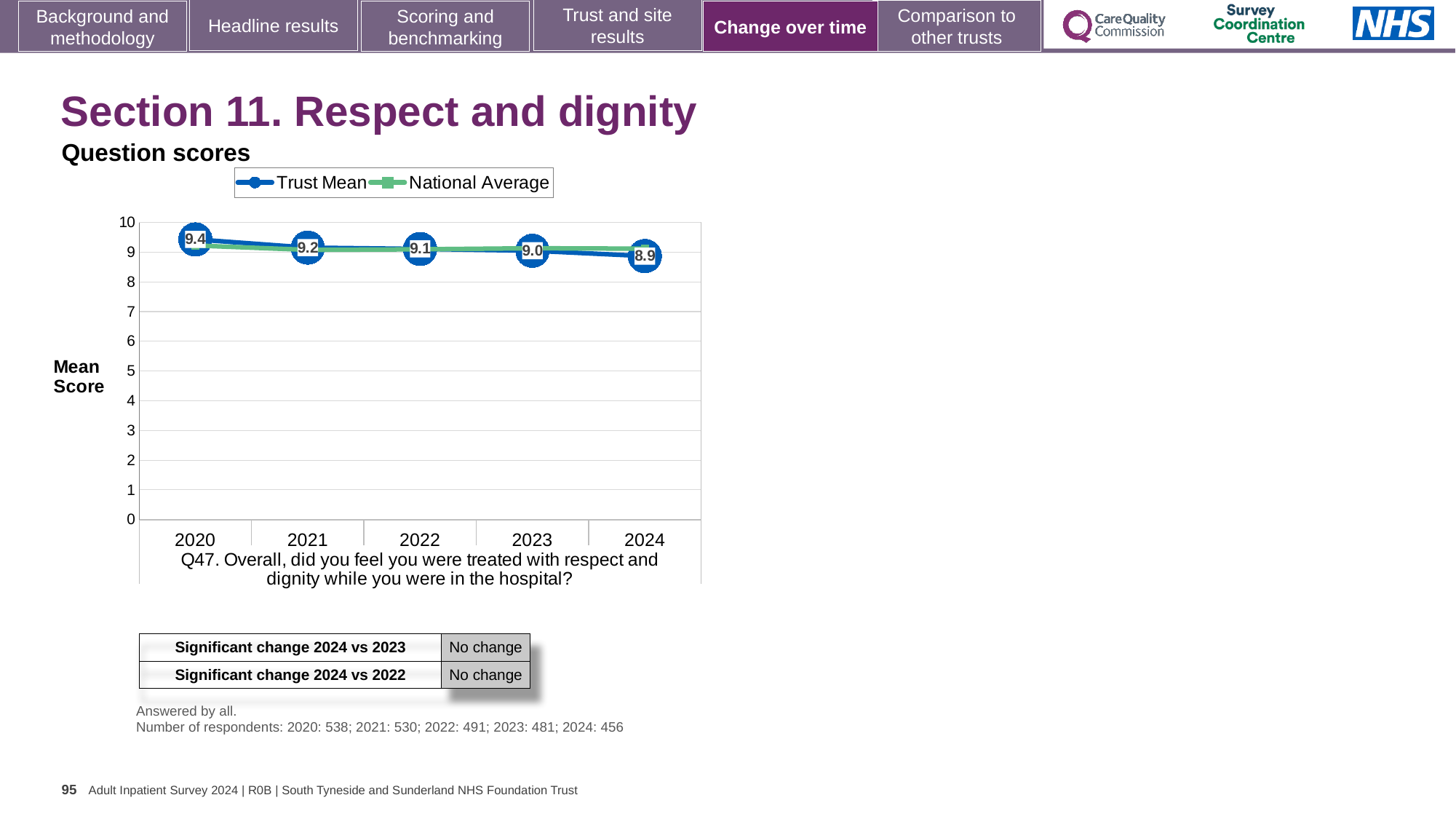
What is the Trust Mean score for 2022? 9.1 Does the Trust Mean score rise or fall from 2020 to 2024? fall In which year is the Trust Mean score lowest? 2024 What is the difference between the Trust Mean score in 2020 and in 2024? 0.5 Is the Trust Mean score for 2024 greater or less than 8? greater In which year is the Trust Mean score highest? 2020 What is the Trust Mean score for 2020? 9.4 What kind of chart is shown on the slide? line chart How many years are plotted on the x axis of the chart? 5 What is the Trust Mean score for 2024? 8.9 How many series does the chart legend list? 2 Which is larger, the Trust Mean score for 2021 or for 2023? 2021